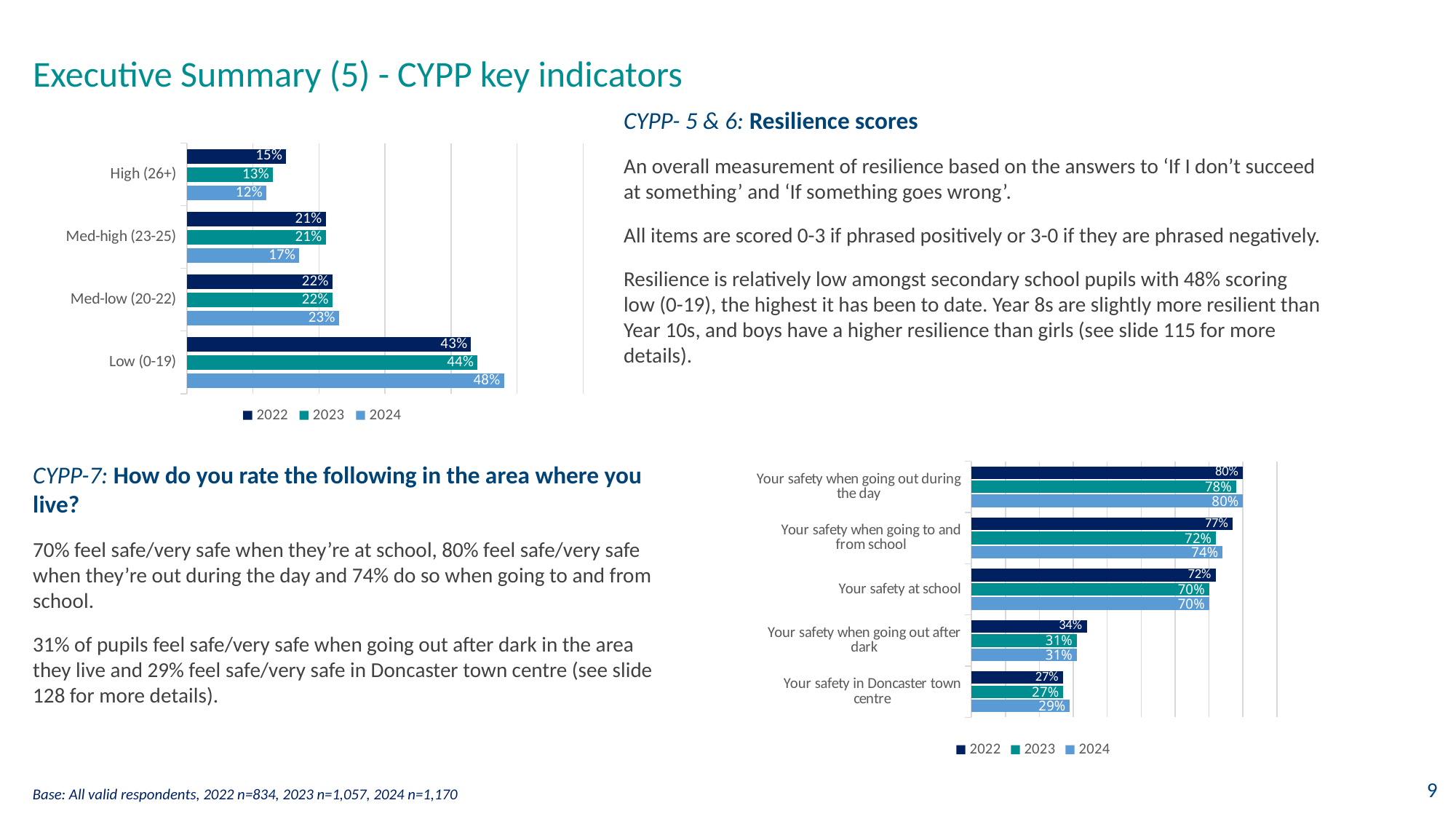
In the top-left chart (resilience scores), which category has the lowest 2022 value? High (26+) In the top-left chart (resilience scores), what is the 2024 value for Low (0-19)? 48% In the top-left chart (resilience scores), which category has the highest 2024 value? Low (0-19) In the bottom-right chart (safety ratings), what is the 2024 value for 'Your safety when going to and from school'? 74% In the bottom-right chart (safety ratings), is the 2023 value for 'Your safety at school' larger or smaller than the 2023 value for 'Your safety when going out during the day'? smaller In the bottom-right chart (safety ratings), how many categories are shown? 5 What type of chart is the bottom-right chart (safety ratings)? bar chart In the top-left chart (resilience scores), what is the difference between the 2024 and 2022 values for Low (0-19)? 5 percentage points In the top-left chart (resilience scores), what is the 2023 value for High (26+)? 13% In the top-left chart (resilience scores), how many series does the legend list? 3 In the bottom-right chart (safety ratings), which category has the lowest 2024 value? Your safety in Doncaster town centre In the bottom-right chart (safety ratings), what is the 2022 value for 'Your safety when going out after dark'? 34%